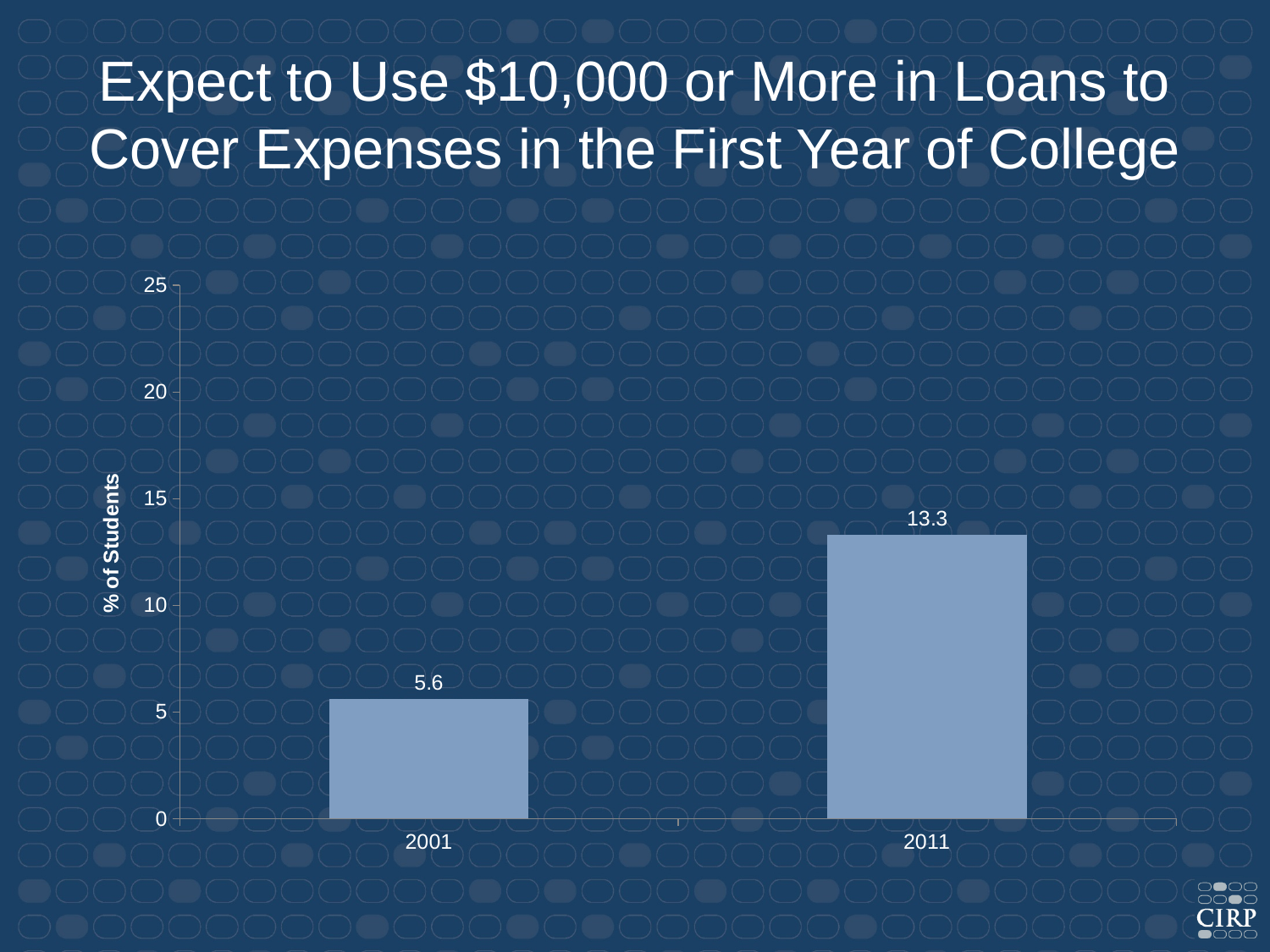
What kind of chart is shown? Bar chart Which year has the lower percentage of students? 2001 Is the value for 2001 greater or less than 5? greater What is the value for 2001? 5.6 Which year has the higher percentage of students? 2011 Do the values rise or fall from 2001 to 2011? Rise How many years are shown on the chart? 2 Is the value for 2011 larger than the value for 2001? Yes What is the difference between the 2011 and 2001 values? 7.7 What is the value for 2011? 13.3 What is the label of the vertical axis? % of Students Is the value for 2011 greater or less than 15? less